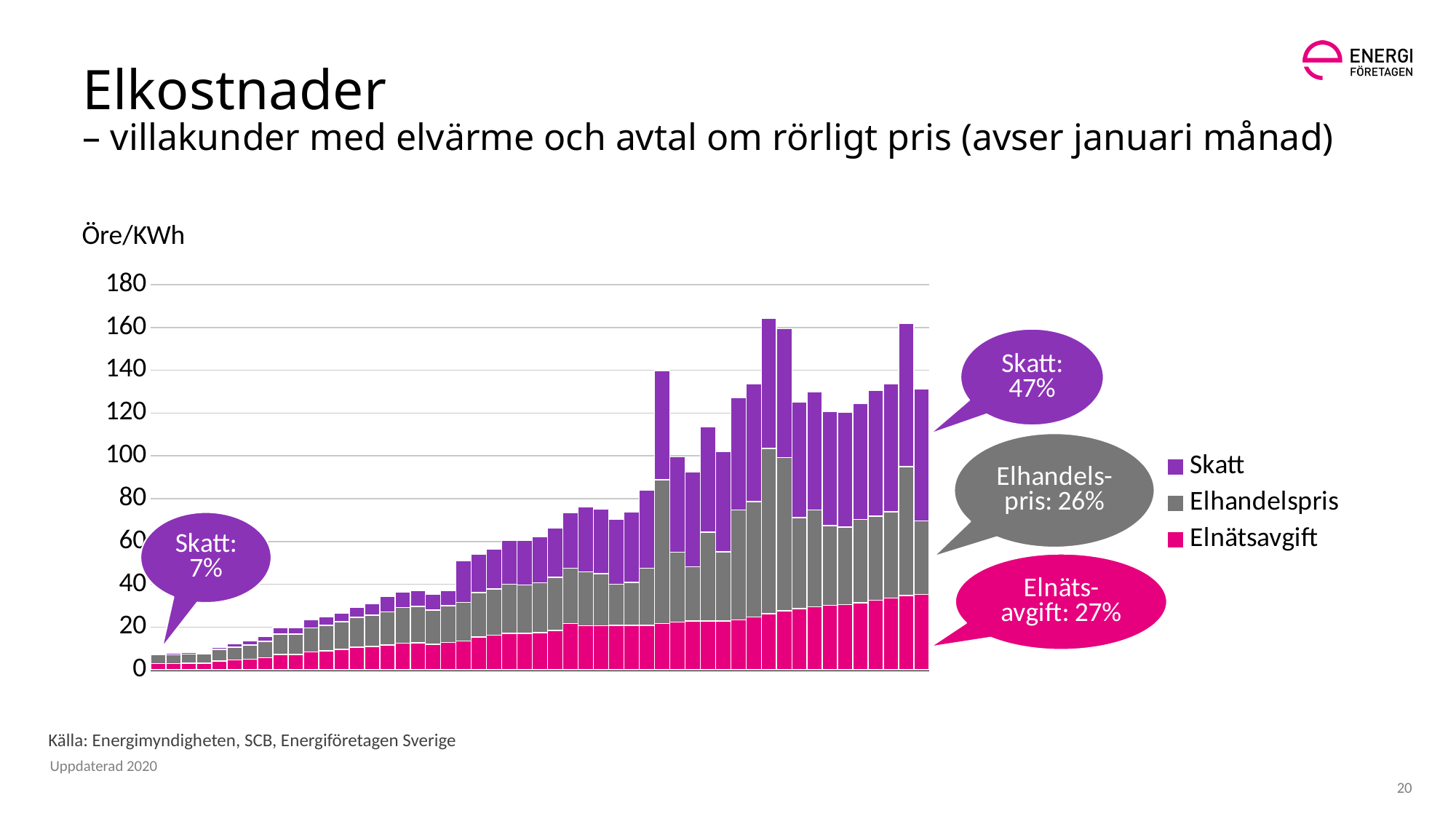
According to the callout on the right of the chart, what share of the cost is Skatt? 47% Is the total of the leftmost bar in the chart greater or less than 20? less Is the total of the tallest bar in the chart greater or less than 140? greater Which three series are listed in the chart legend? Skatt, Elhandelspris, Elnätsavgift According to the callout on the right of the chart, what share of the cost is Elhandelspris? 26% What kind of chart is shown on the slide? Stacked bar chart In the rightmost bar, which series has the largest segment? Skatt Do the total bar heights generally rise or fall from left to right along the x axis? Rise What unit is shown above the y axis of the chart? Öre/KWh According to the callout on the right of the chart, what share of the cost is Elnätsavgift? 27% How many series does the chart legend list? 3 According to the callout at the left of the chart, what share of the cost was Skatt at the start of the period? 7%